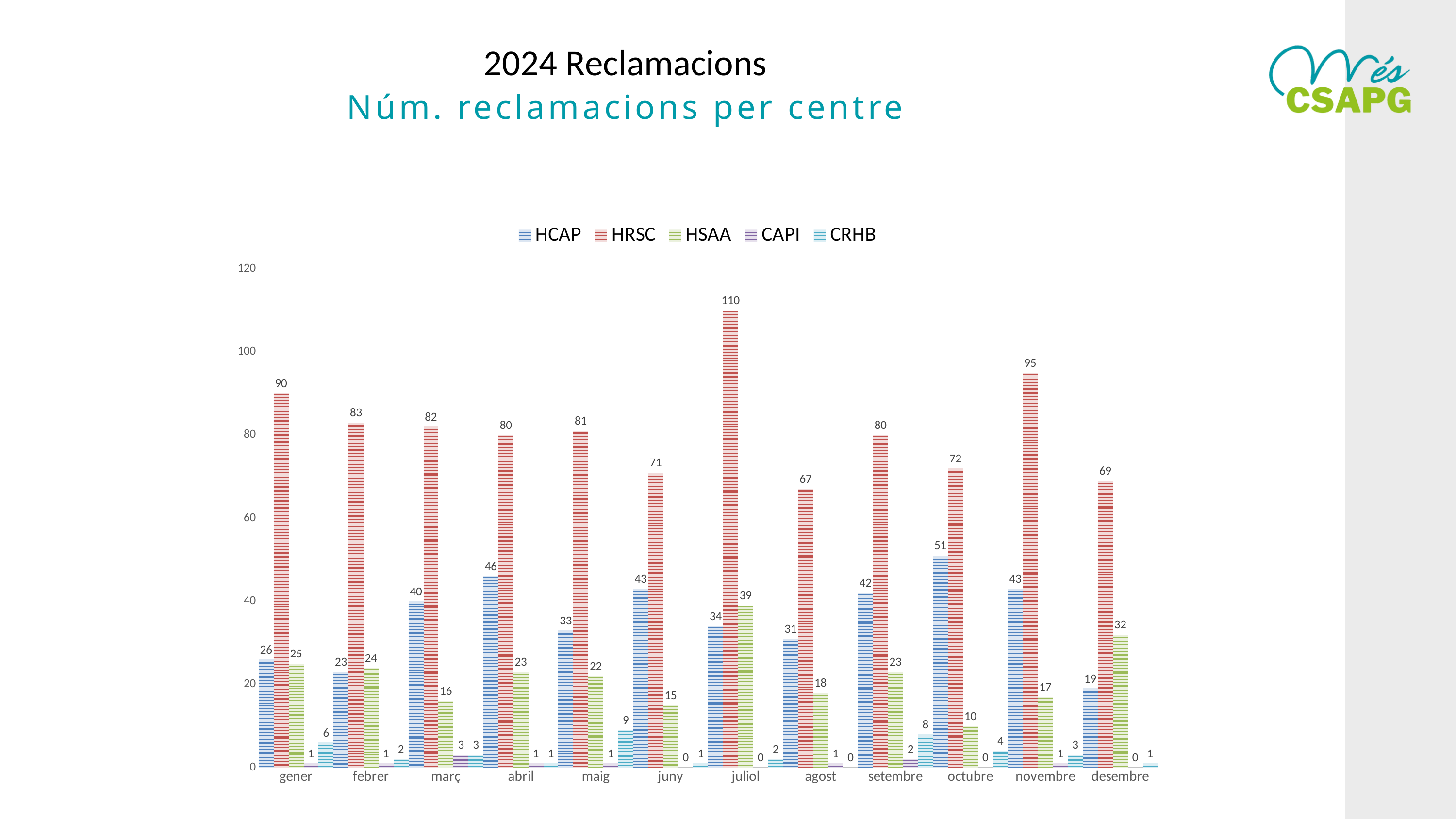
In which month is the HRSC value lowest? agost What is the difference between the HRSC values in juliol and novembre? 15 What is the value for HRSC in juliol? 110 What is the value for HCAP in octubre? 51 What is the value for HSAA in desembre? 32 In which month is the HRSC value highest? juliol Which is larger, the HCAP value in abril or the HCAP value in setembre? abril What is the value for CRHB in gener? 6 What kind of chart is shown on the slide? bar chart What is the subtitle of the chart shown in teal text? Núm. reclamacions per centre How many series does the legend list? 5 How many months are shown on the x axis? 12